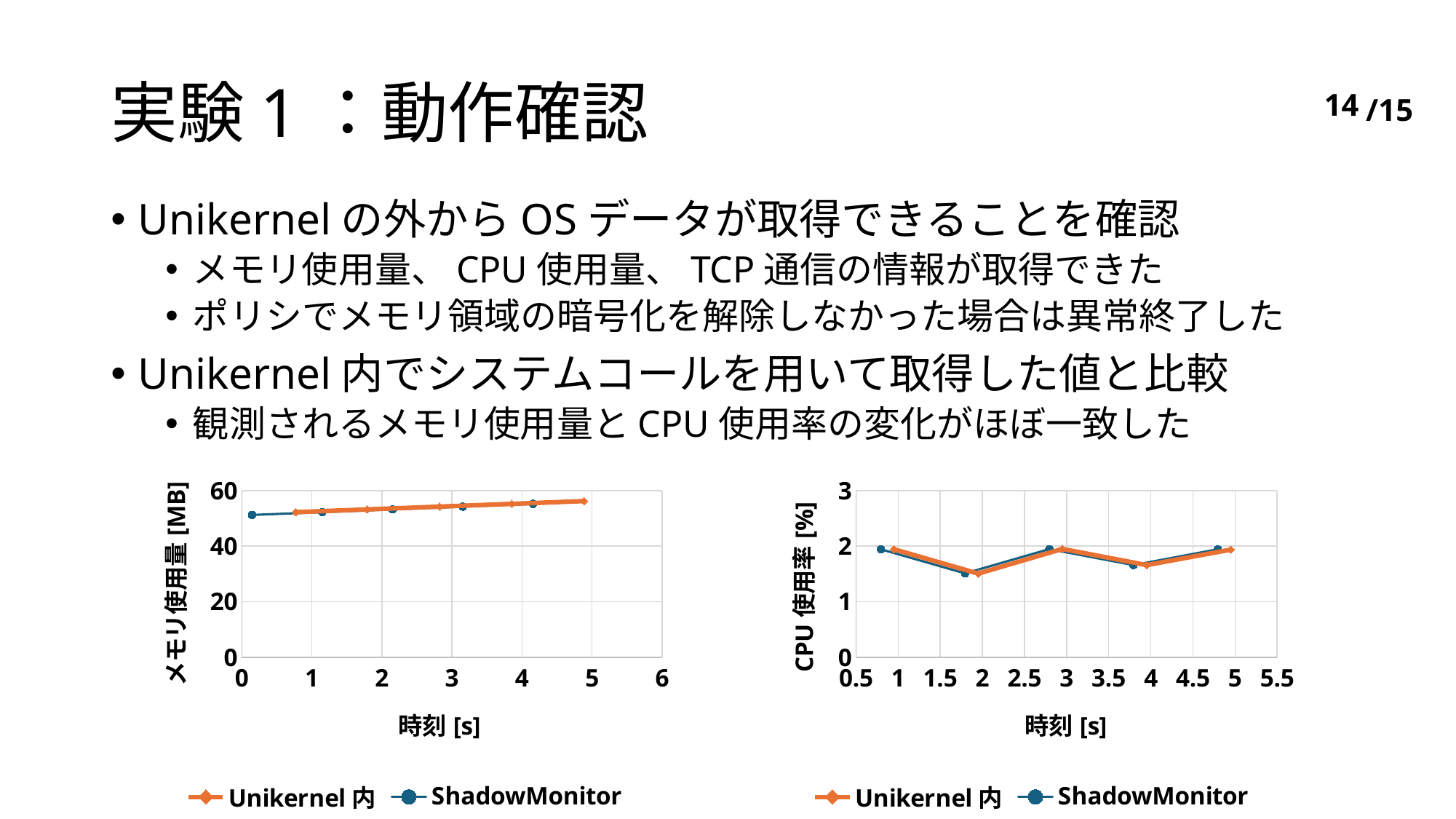
How many series does the legend of the left chart list? 2 How many data points does the Unikernel 内 series have in the right chart? 5 In the left chart, is the ShadowMonitor value at around 4 s greater or less than 60? less In the left chart, do the memory usage values rise or fall as time increases? rise What are the two series named in the legend of the right chart? Unikernel 内 and ShadowMonitor What kind of chart is the left chart (メモリ使用量 [MB])? line chart What is the y-axis title of the left chart? メモリ使用量 [MB] What kind of chart is the right chart (CPU 使用率 [%])? line chart In the left chart, is the Unikernel 内 value at around 1 s greater or less than 40? greater In the right chart, is the Unikernel 内 value at 2 s greater or less than 2? less